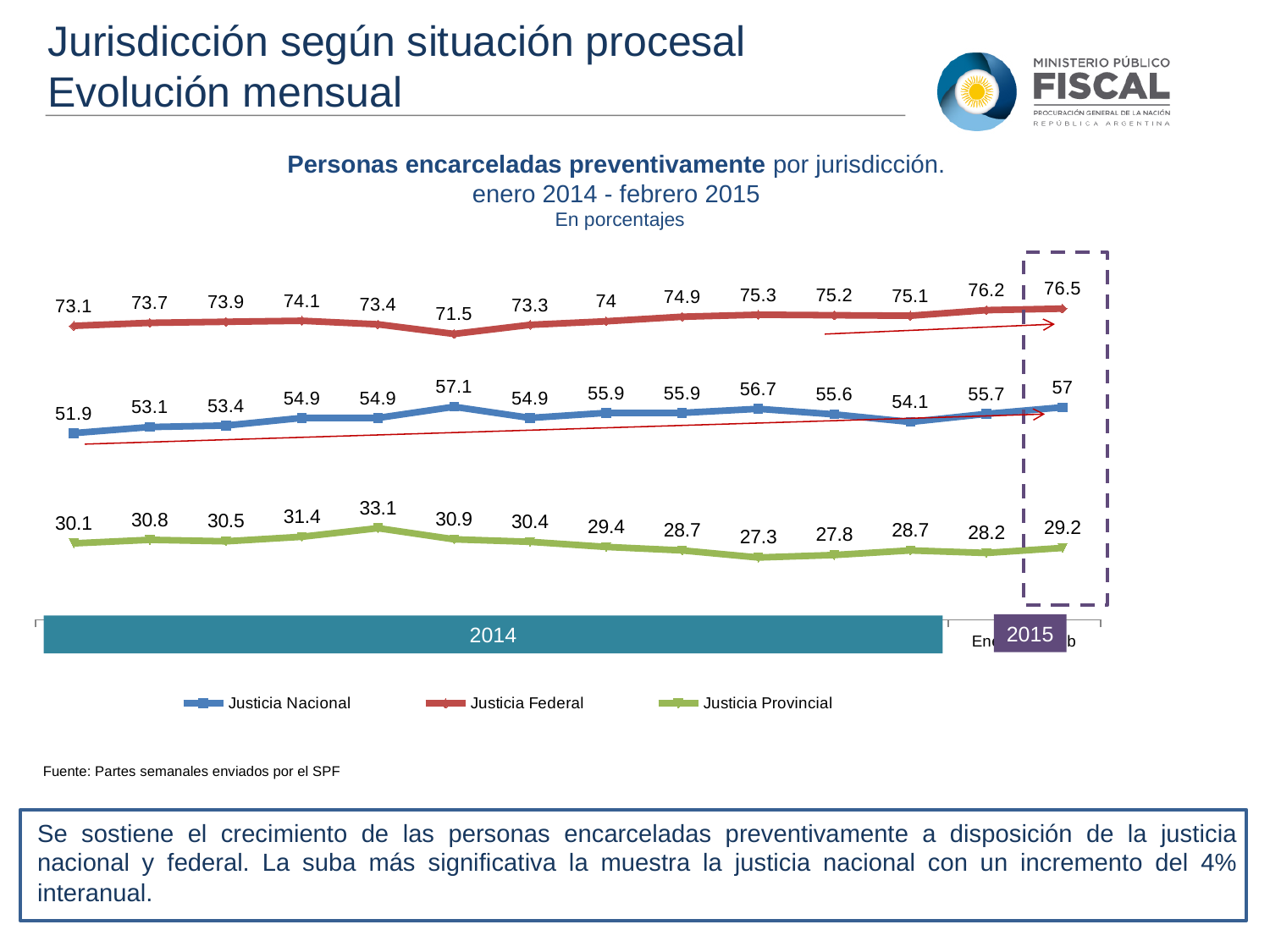
What is the highest value reached by Justicia Provincial? 33.1 How many series does the legend list? 3 What is the first (January 2014) value for Justicia Nacional? 51.9 What is the last (February 2015) value for Justicia Federal? 76.5 What is the lowest value reached by Justicia Federal? 71.5 By how much did Justicia Nacional change from its first value (51.9) to its last value (57)? 5.1 Which series is drawn in green? Justicia Provincial How many data points are plotted for each series? 14 What type of chart is shown on the slide? line chart What is the highest value reached by Justicia Nacional? 57.1 At the last data point, which is larger: Justicia Federal or Justicia Provincial? Justicia Federal Does the Justicia Federal series rise or fall overall from the first point to the last? rise